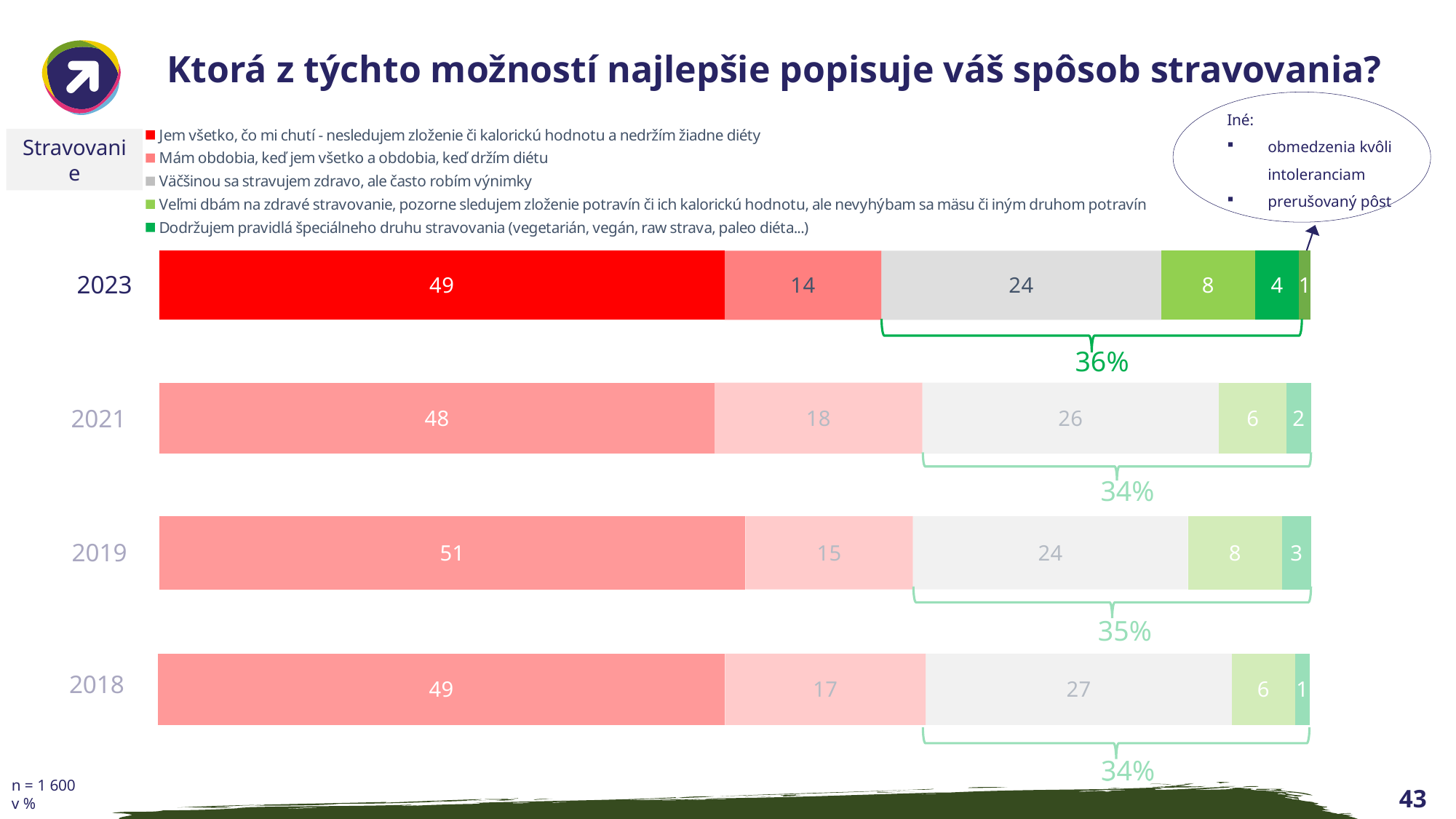
What is the value for "Dodržujem pravidlá špeciálneho druhu stravovania" in 2023? 4 What is the difference between the 2021 and 2023 values for "Mám obdobia, keď jem všetko a obdobia, keď držím diétu"? 4 How many series does the legend list? 5 Which year has the larger value for "Väčšinou sa stravujem zdravo, ale často robím výnimky": 2018 or 2023? 2018 What kind of chart is shown on the slide? Stacked bar chart In which year is the value for "Jem všetko, čo mi chutí" the highest? 2019 What sample size (n) is stated on the slide? n = 1 600 What is the value for "Mám obdobia, keď jem všetko a obdobia, keď držím diétu" in 2019? 15 What percentage is shown under the bracket for the 2023 bar? 36% How many years are shown in the chart? 4 What is the value for "Jem všetko, čo mi chutí" in 2023? 49 What is the value for "Väčšinou sa stravujem zdravo, ale často robím výnimky" in 2021? 26